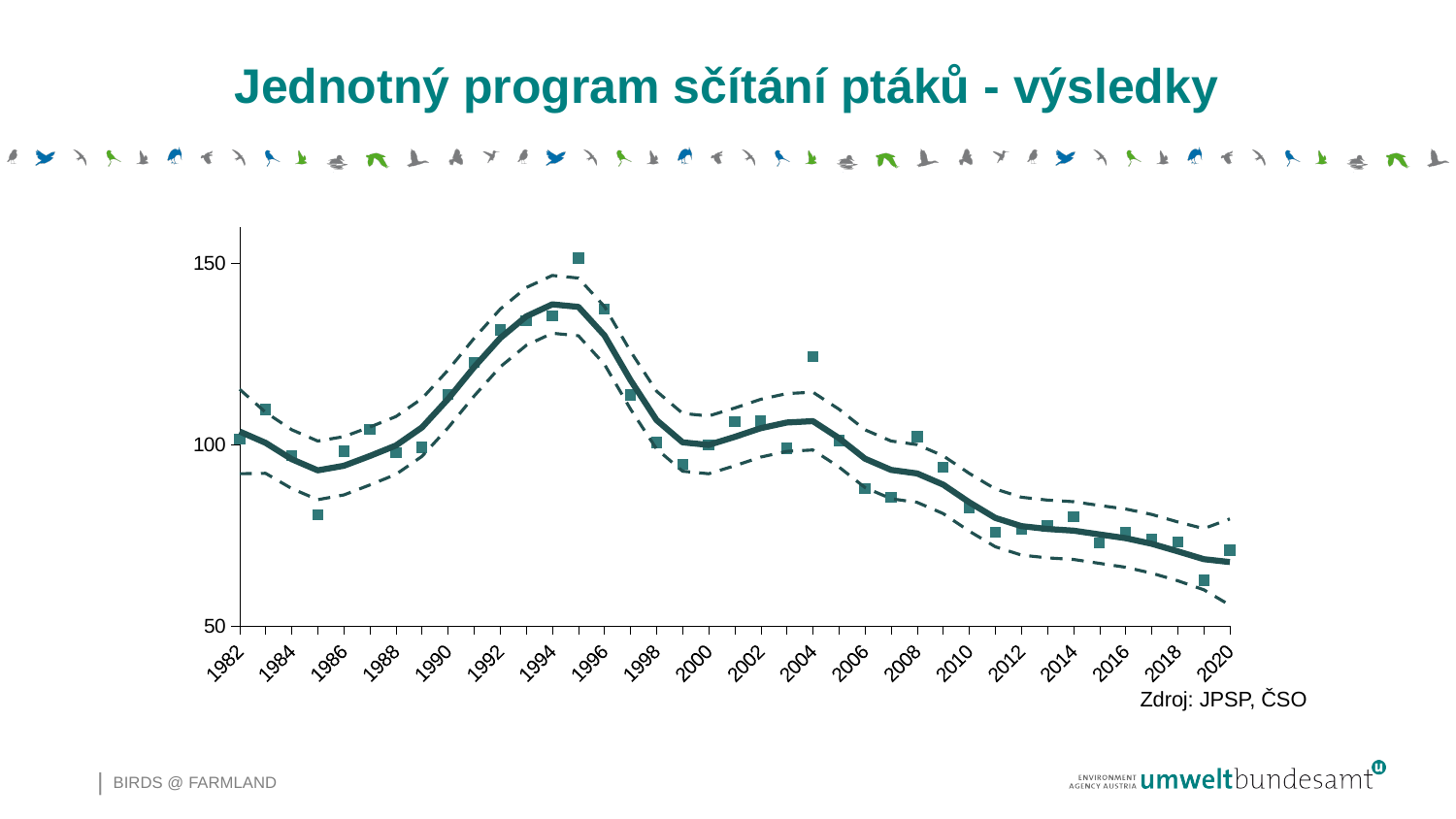
Does the trend line rise or fall between 2004 and 2020? fall Is the value for 1985 greater or less than 100? less Is the value for 1993 greater or less than 100? greater Is the value for 2010 greater or less than 100? less In which year does the plotted index reach its highest point? 1995 Which year has the larger value, 1995 or 2004? 1995 In which year does the plotted index reach its lowest point? 2019 What kind of chart is shown on the slide? line chart What source is cited below the chart? Zdroj: JPSP, ČSO What is the title of the chart on the slide? Jednotný program sčítání ptáků - výsledky Which year has the larger value, 1985 or 2019? 1985